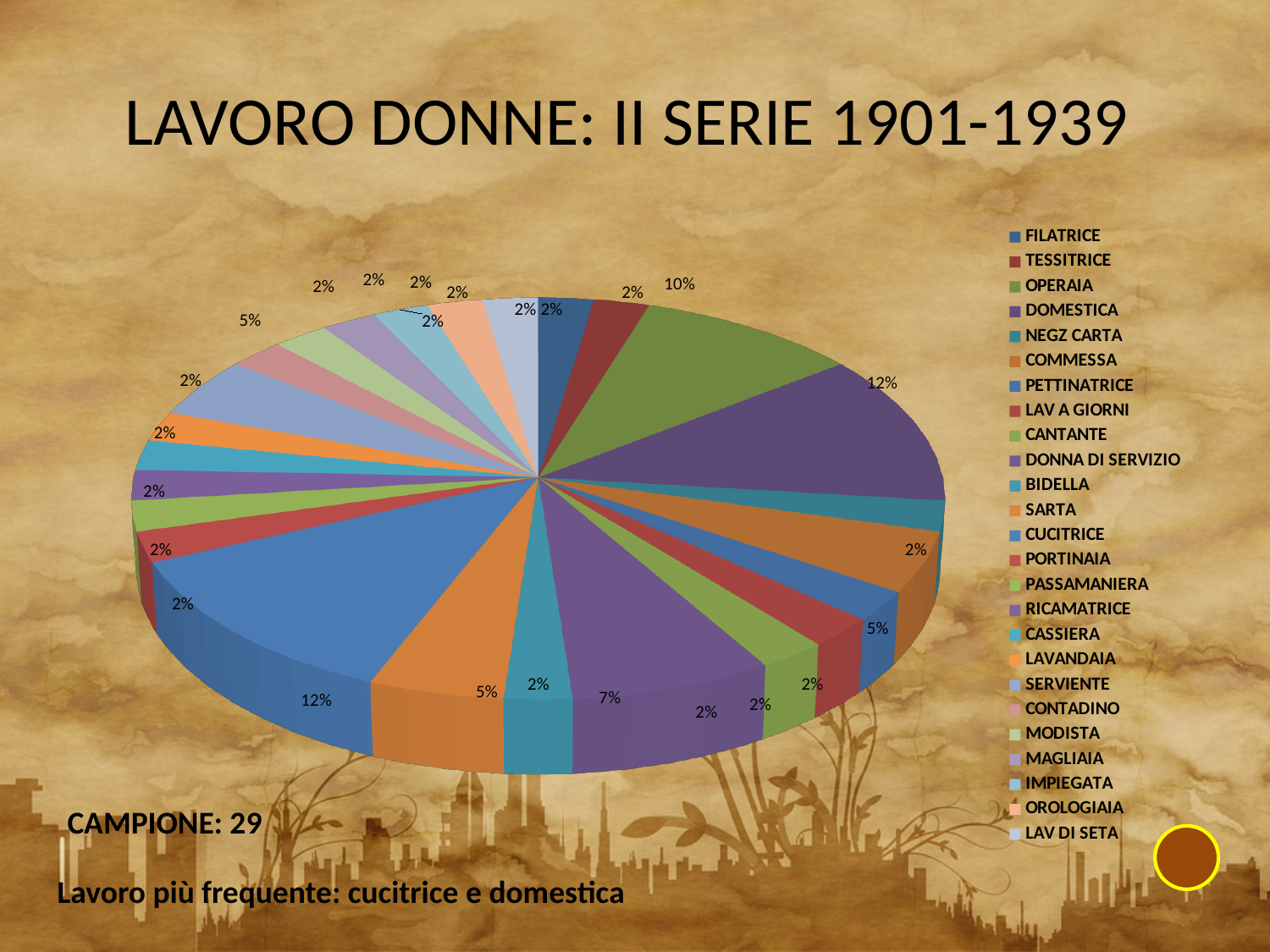
What kind of chart is shown on the slide? Pie chart What is the value shown for CUCITRICE? 12% Which two categories have the largest slices of the pie? CUCITRICE and DOMESTICA Which is larger, the slice for COMMESSA or the slice for DONNA DI SERVIZIO? DONNA DI SERVIZIO What share of the pie does OPERAIA represent? 10% What is the value shown for DONNA DI SERVIZIO? 7% What sample size (CAMPIONE) is stated on the slide? 29 What is the value shown for DOMESTICA? 12% What is the difference between the DOMESTICA slice and the OPERAIA slice? 2% Which is larger, the slice for OPERAIA or the slice for DONNA DI SERVIZIO? OPERAIA How many categories does the legend of the pie chart list? 25 What is the title of the chart? LAVORO DONNE: II SERIE 1901-1939